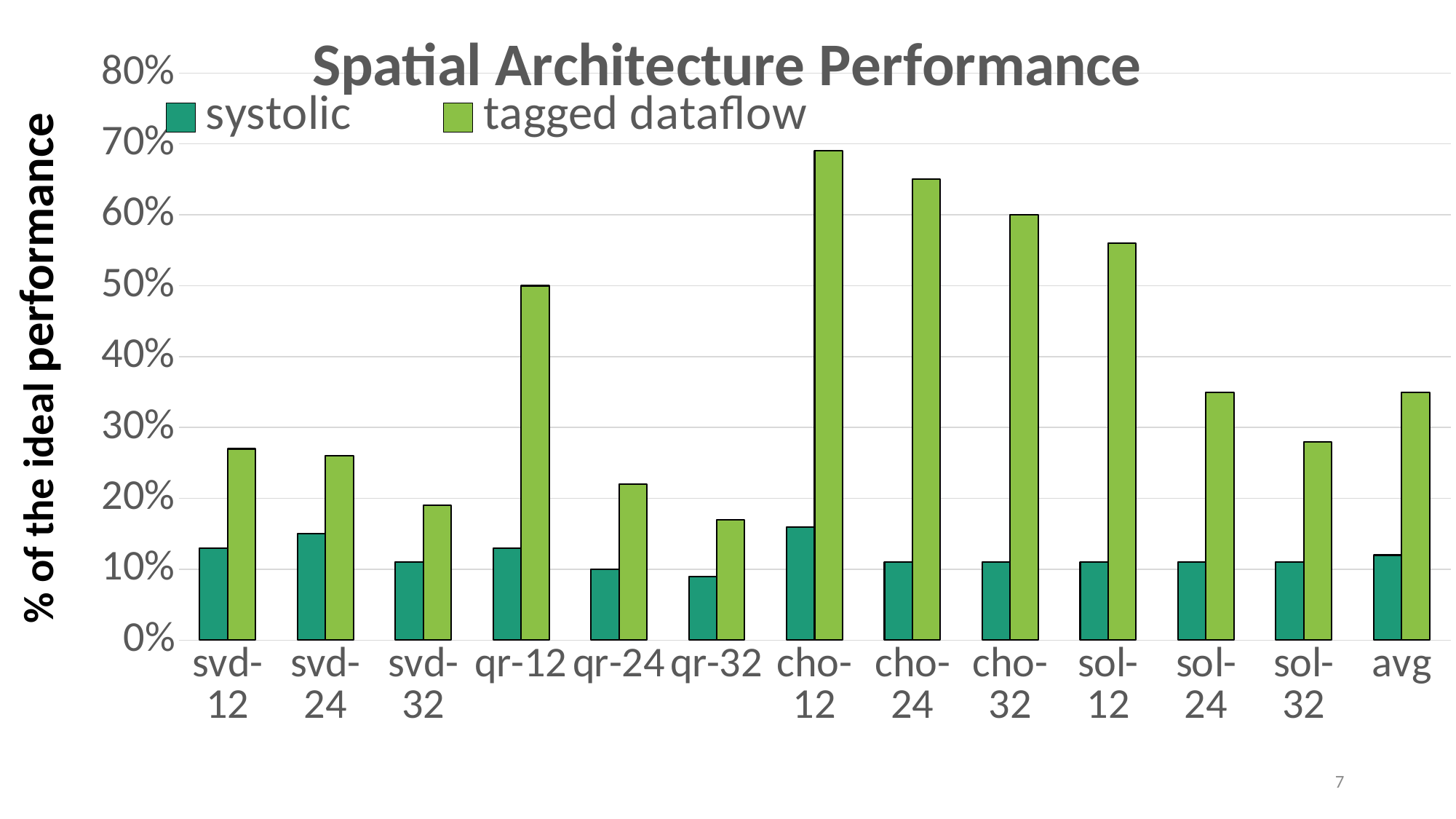
Which category has the lowest tagged dataflow value? qr-32 Which is larger, the tagged dataflow value for sol-12 or for sol-24? sol-12 How many series does the legend list? 2 Which category has the highest tagged dataflow value? cho-12 Is the tagged dataflow value for cho-12 greater or less than 60%? greater Is the systolic value for svd-12 greater or less than 20%? less What kind of chart is shown on the slide? bar chart What is the title of the chart? Spatial Architecture Performance For the avg category, which series has the larger value, systolic or tagged dataflow? tagged dataflow How many categories are shown along the x axis? 13 What is the tagged dataflow value for qr-12? 50%